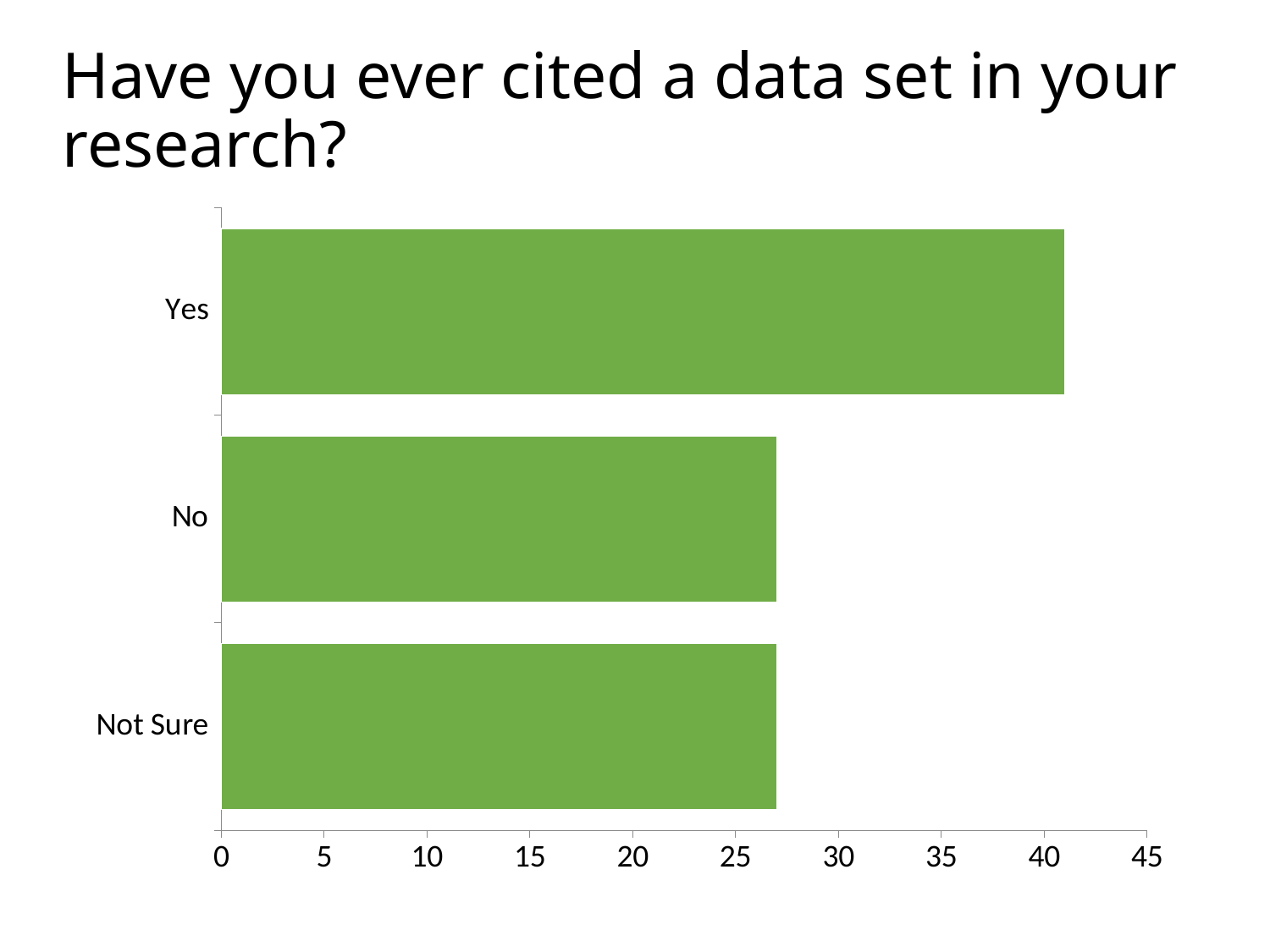
What kind of chart is shown on the slide? bar chart Is the value for Yes greater or less than 40? greater Is the value for No greater or less than 25? greater Which category has the highest value? Yes What colour are the bars in the chart? green Is the value for Yes greater or less than 45? less Which is larger, the value for Yes or the value for No? Yes What is the title of the slide above the chart? Have you ever cited a data set in your research? How many categories are shown in the chart? 3